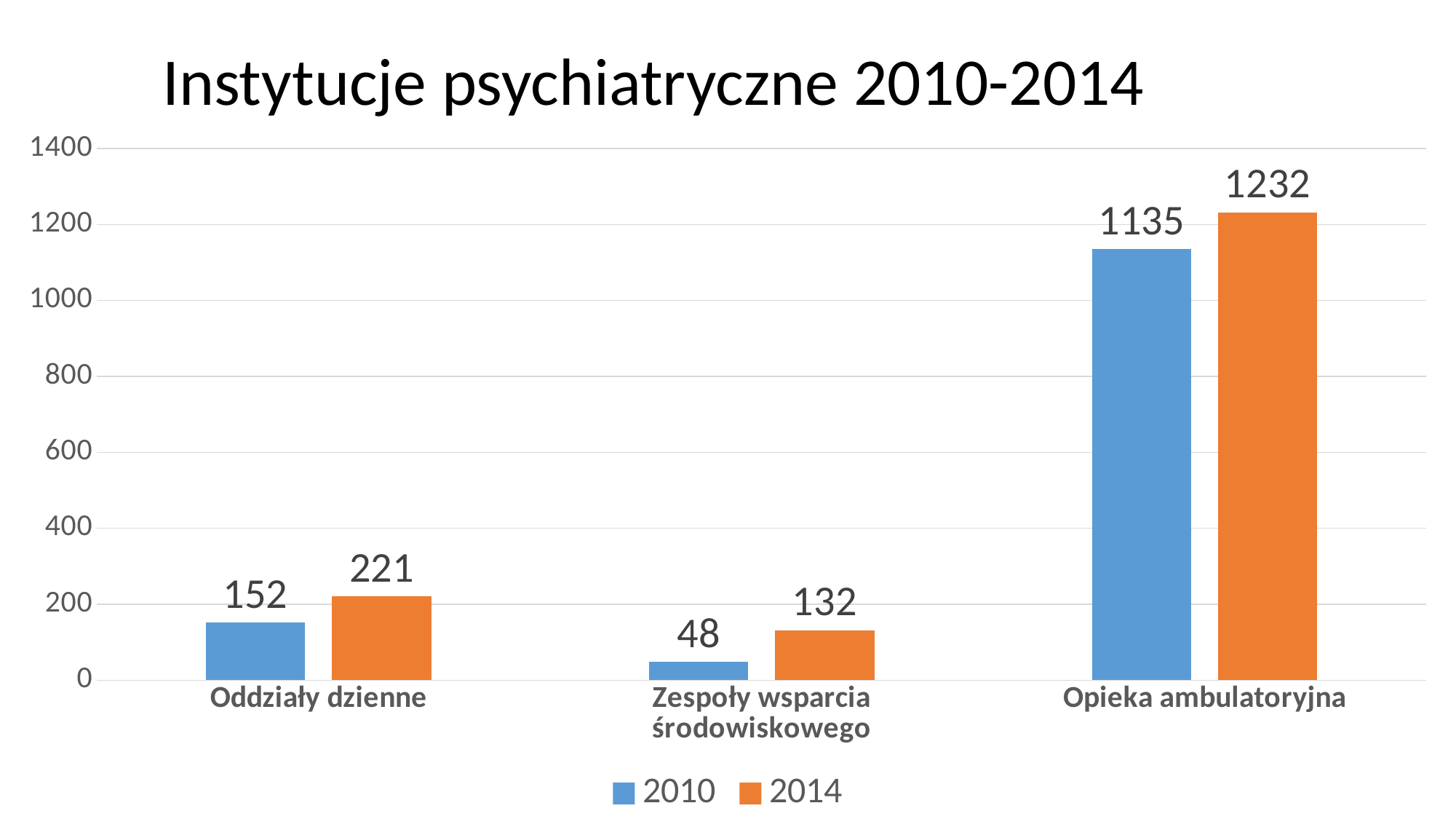
What is the difference between the 2014 and 2010 values for Oddziały dzienne? 69 Which is larger for Zespoły wsparcia środowiskowego: the 2010 value or the 2014 value? 2014 What is the difference between the 2014 and 2010 values for Opieka ambulatoryjna? 97 What is the value for Opieka ambulatoryjna in 2010? 1135 Which category has the lowest value in 2010? Zespoły wsparcia środowiskowego What is the value for Zespoły wsparcia środowiskowego in 2014? 132 How many series does the legend list? 2 How many categories are shown on the x axis? 3 What kind of chart is shown on the slide? Bar chart Which category has the highest value in 2014? Opieka ambulatoryjna What is the title of the chart? Instytucje psychiatryczne 2010-2014 What is the value for Oddziały dzienne in 2010? 152